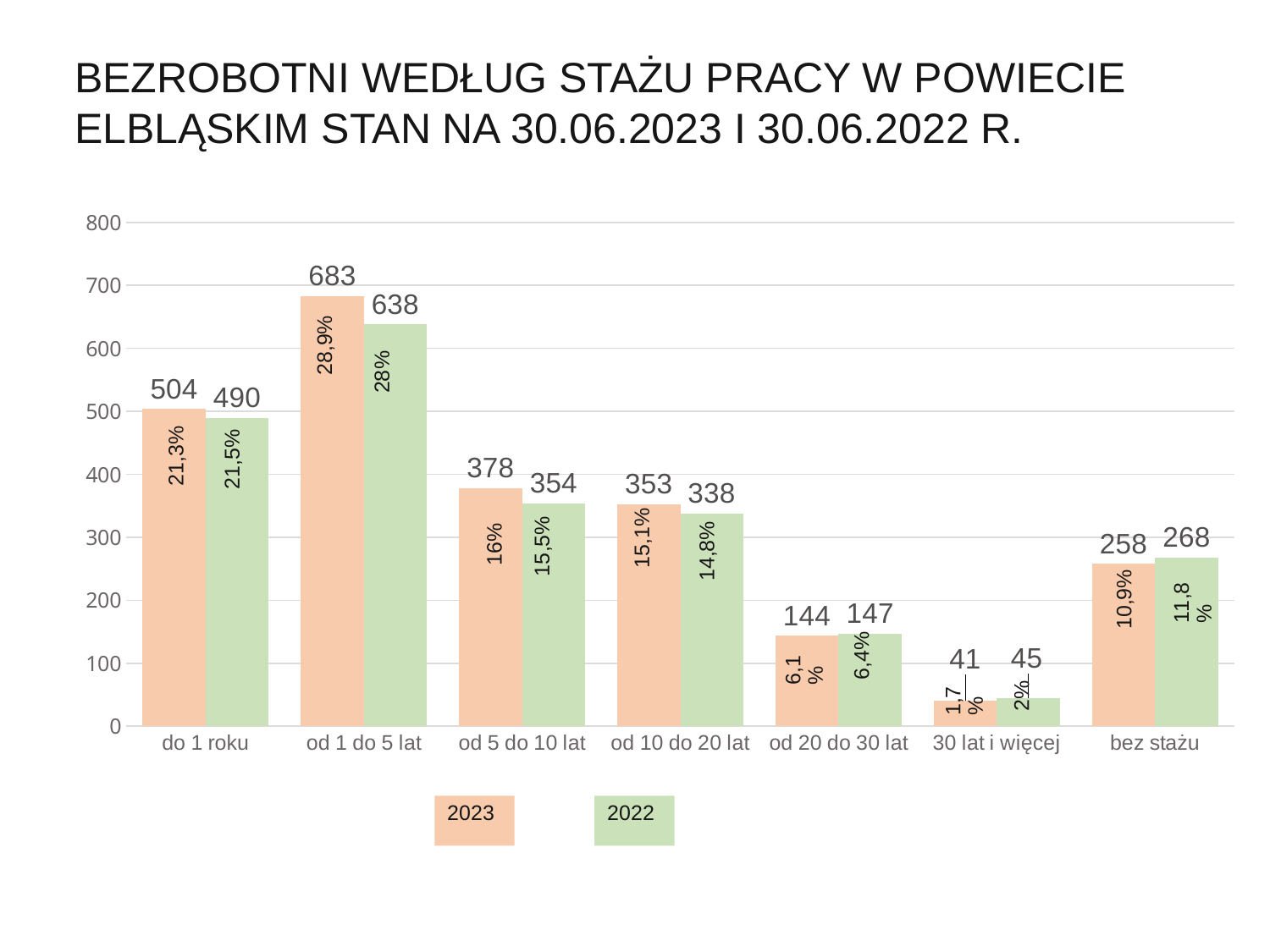
Which is larger for 'od 20 do 30 lat': the 2023 value or the 2022 value? 2022 Which category has the lowest 2022 value? 30 lat i więcej Which category has the highest 2023 value? od 1 do 5 lat Is the 2023 value for 'od 10 do 20 lat' greater or less than 300? greater What is the difference between the 2023 and 2022 values for 'od 5 do 10 lat'? 24 What is the 2023 value for the category 'od 1 do 5 lat'? 683 How many categories are shown on the x axis? 7 How many series does the legend list? 2 What is the 2022 value for the category 'bez stażu'? 268 Which series is shown in green in the legend? 2022 What kind of chart is shown on the slide? bar chart What percentage label is shown on the 2023 bar for 'do 1 roku'? 21,3%